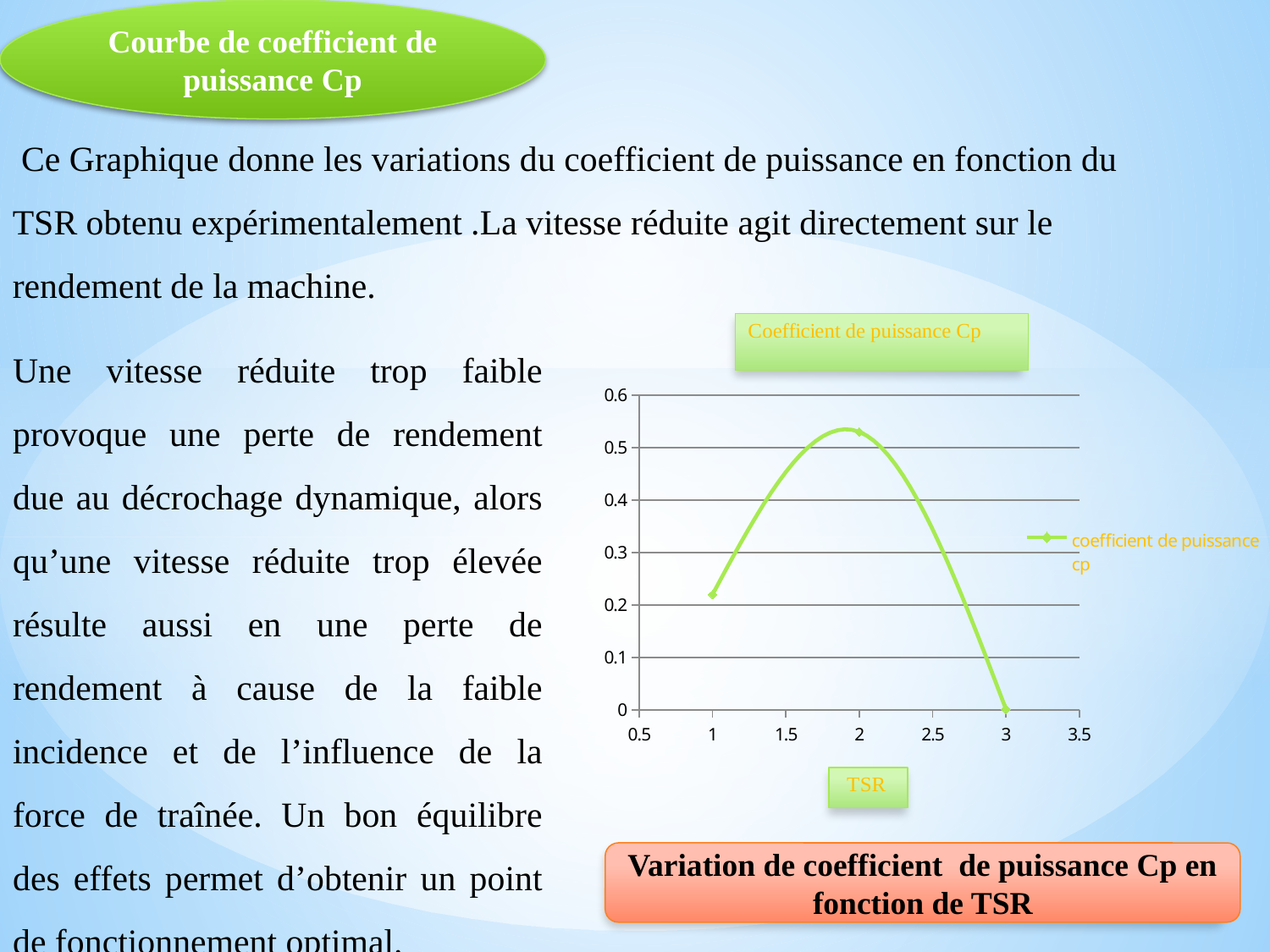
How does the coefficient de puissance cp change as TSR increases from 1 to 3? rises then falls How many series does the chart legend list? 1 At which TSR value is the coefficient de puissance cp lowest? 3 What is the title of the chart? Coefficient de puissance Cp How many data points are marked on the curve? 3 Is the value of coefficient de puissance cp at TSR 2 greater or less than 0.4? greater At which TSR value does the coefficient de puissance cp reach its highest point? 2 What label is shown for the x axis of the chart? TSR Is the value of coefficient de puissance cp at TSR 1 greater or less than 0.3? less What type of chart is shown on the slide? line chart Which has a larger coefficient de puissance cp: TSR 1 or TSR 2? TSR 2